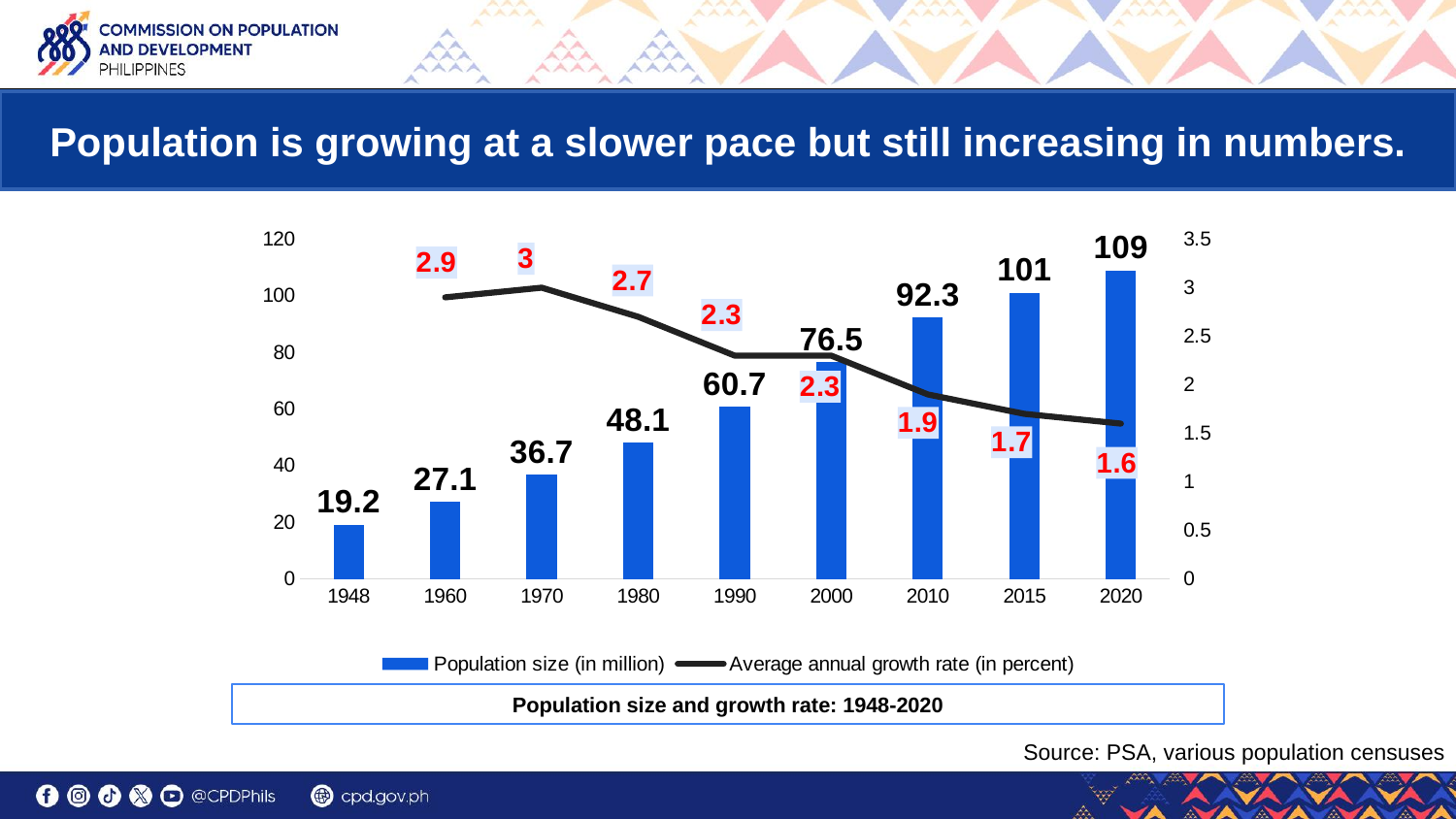
How many series does the legend list? 2 Which year has the lowest average annual growth rate shown on the line? 2020 Which year has the highest population size? 2020 Does the average annual growth rate rise or fall from 1970 to 2020? Fall Which is larger, the population size in 1990 or in 1980? 1990 What was the population size (in million) in 1948? 19.2 What was the average annual growth rate (in percent) in 2020? 1.6 What was the population size (in million) in 2020? 109 How many years are shown on the x axis? 9 What kind of chart is used to show population size? Bar chart What is the difference in population size (in million) between 2010 and 2000? 15.8 What was the average annual growth rate (in percent) in 1970? 3